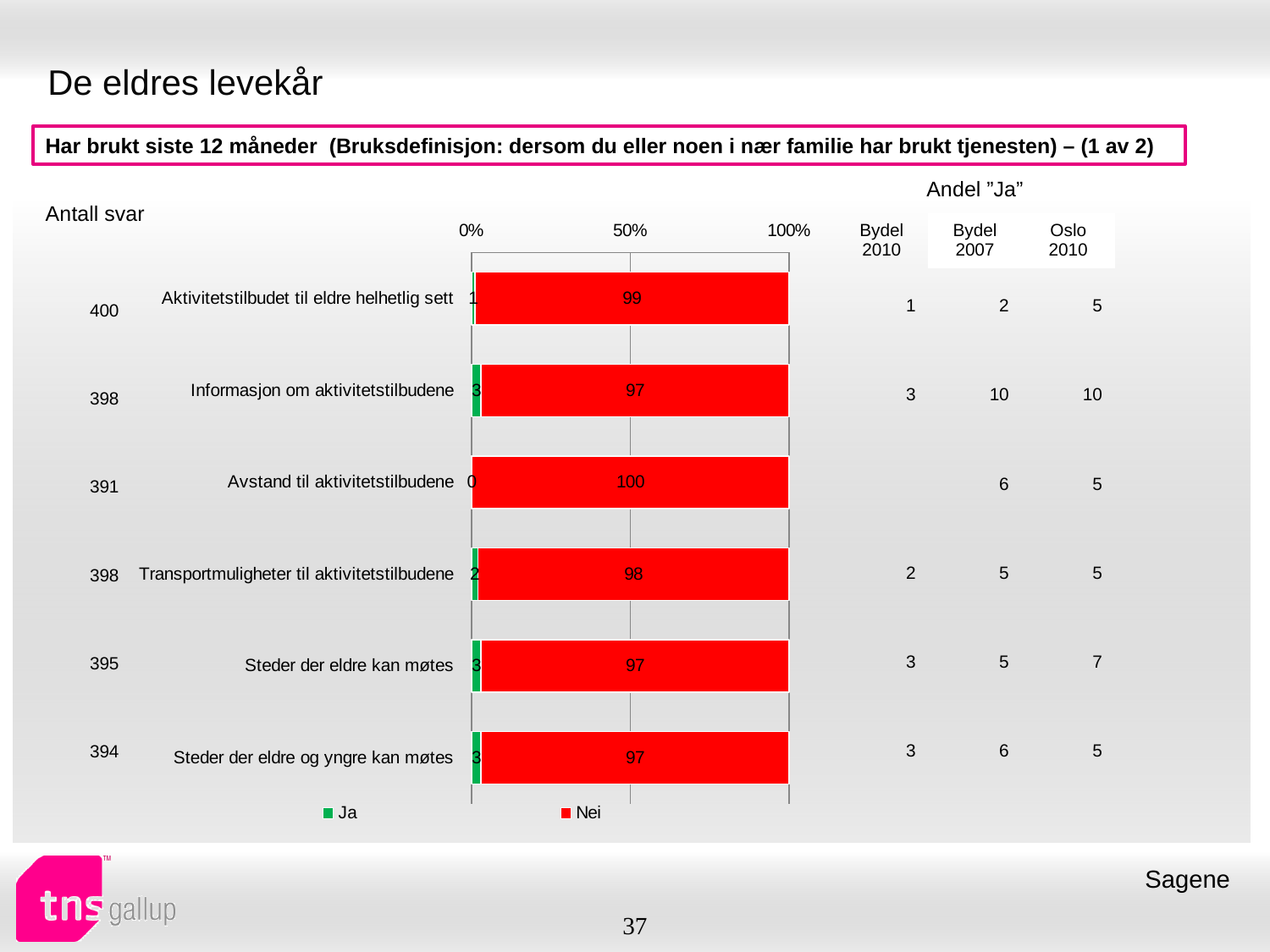
What is the 'Ja' value for 'Informasjon om aktivitetstilbudene'? 3 How many series does the chart legend list? 2 What is the 'Nei' value for 'Avstand til aktivitetstilbudene'? 100 What kind of chart is shown on the slide? bar chart Which series is shown in red in the chart? Nei Which is larger: the 'Nei' value for 'Aktivitetstilbudet til eldre helhetlig sett' or for 'Steder der eldre og yngre kan møtes'? Aktivitetstilbudet til eldre helhetlig sett What is the difference between the 'Nei' values for 'Avstand til aktivitetstilbudene' and 'Steder der eldre kan møtes'? 3 How many categories are plotted in the chart? 6 What is the 'Nei' value for 'Aktivitetstilbudet til eldre helhetlig sett'? 99 Which category has the highest 'Nei' value? Avstand til aktivitetstilbudene Which category has the lowest 'Ja' value? Avstand til aktivitetstilbudene What is the 'Nei' value for 'Transportmuligheter til aktivitetstilbudene'? 98